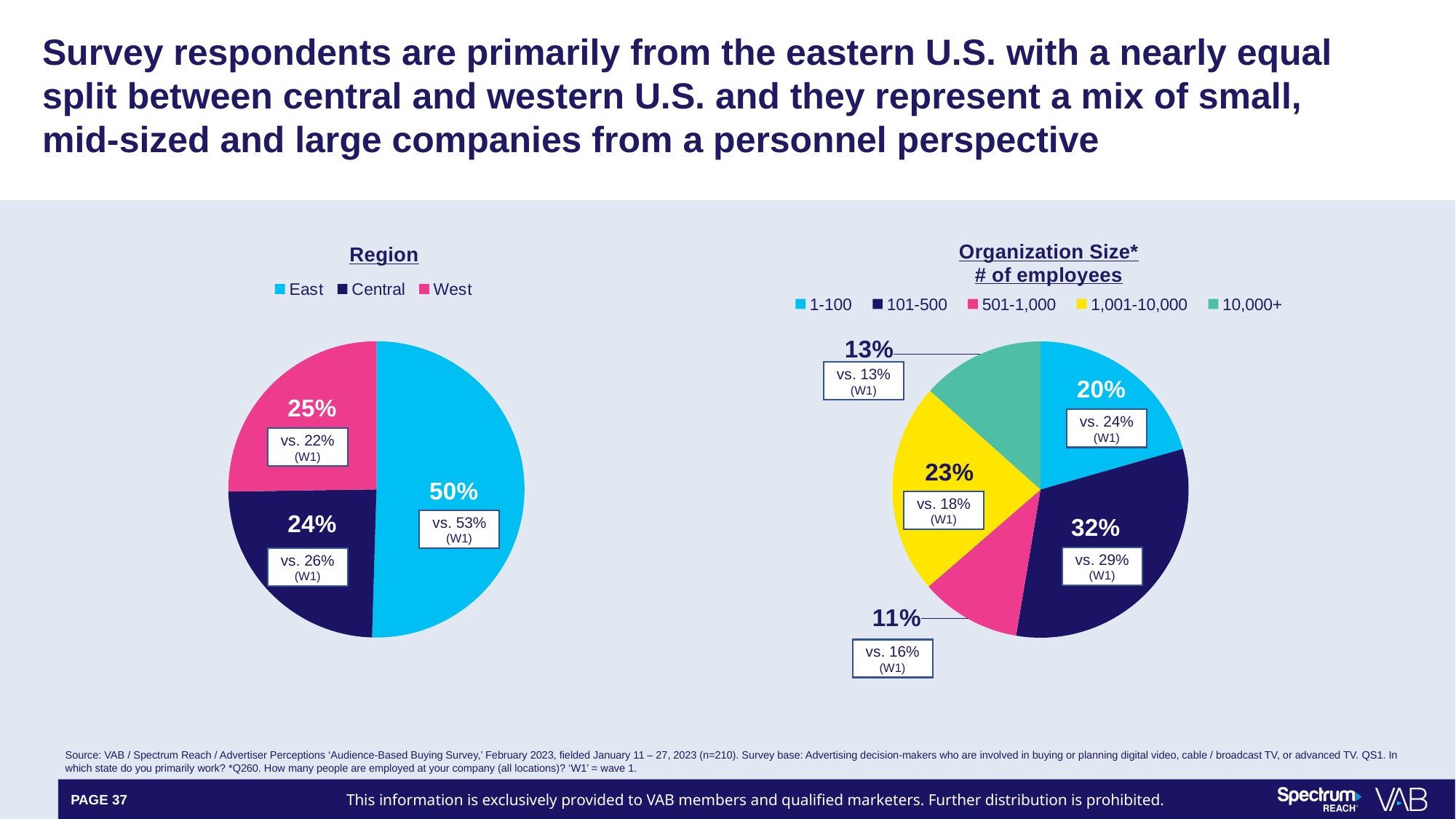
In the Organization Size chart, what share of respondents have 101-500 employees? 32% In the Region chart, what share of respondents are from the East? 50% In the Region chart, which region has the largest share? East In the Organization Size chart, which employee-size category has the smallest share? 501-1,000 In the Organization Size chart, what was the W1 share for 1-100 employees? 24% How many categories does the legend of the Organization Size chart list? 5 In the Region chart, what is the difference between the East and Central shares? 26% What type of chart is the Region chart? Pie chart In the Region chart, what was the Central share in W1? 26% In the Organization Size chart, which employee-size category has the largest share? 101-500 In the Organization Size chart, is the share for 1,001-10,000 employees larger or smaller than the share for 1-100 employees? Larger In the Region chart, what share of respondents are from the West? 25%